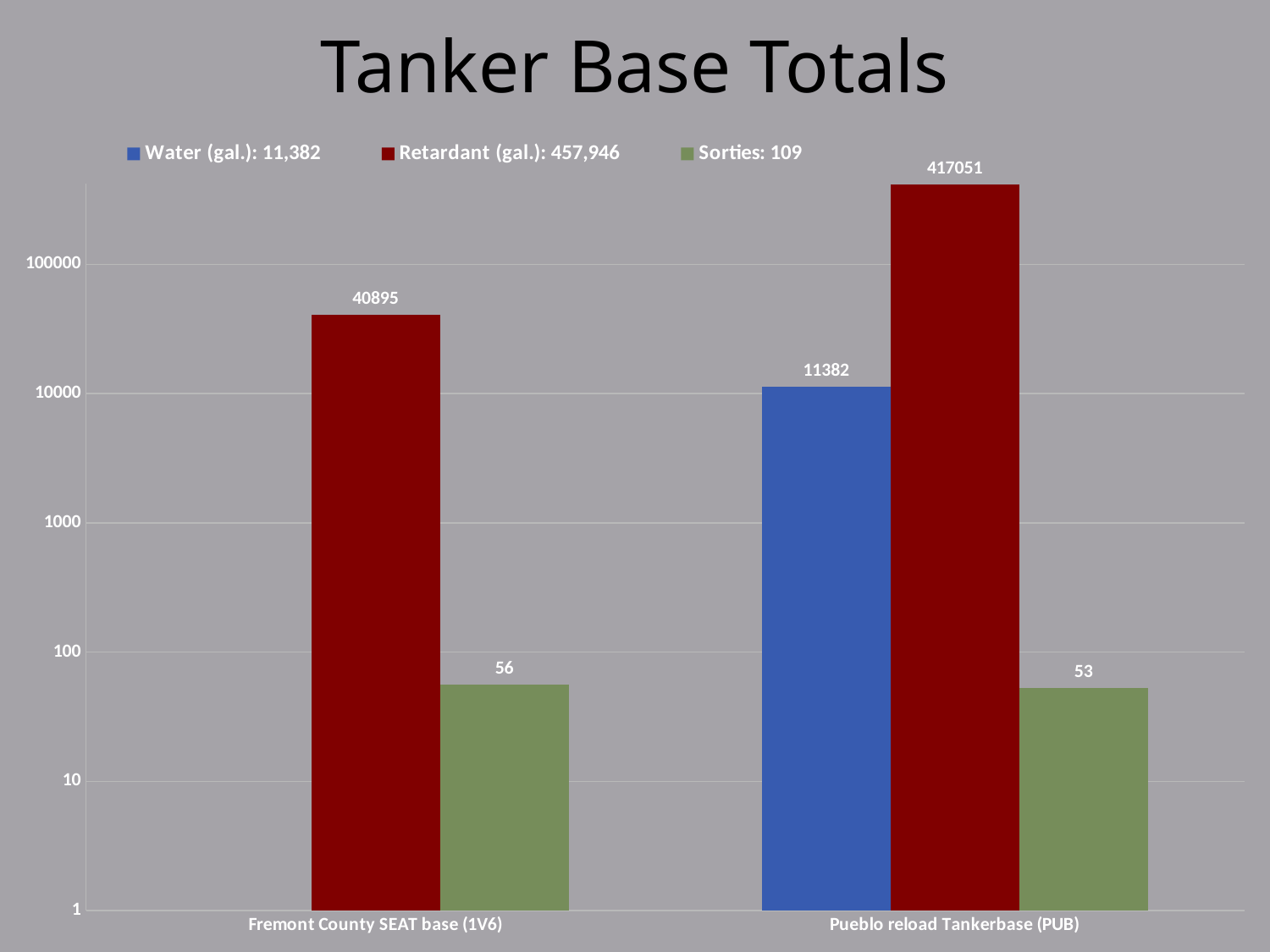
What is the difference in Retardant (gal.) between Pueblo reload Tankerbase (PUB) and Fremont County SEAT base (1V6)? 376156 Is the Retardant (gal.) value for Fremont County SEAT base (1V6) greater or less than 10000? greater How many series does the legend list? 3 Which base has the higher Retardant (gal.) value? Pueblo reload Tankerbase (PUB) Which base has the lower number of Sorties? Pueblo reload Tankerbase (PUB) What is the Retardant (gal.) value for Fremont County SEAT base (1V6)? 40895 What kind of chart is shown on the slide? Bar chart What is the difference in Sorties between Fremont County SEAT base (1V6) and Pueblo reload Tankerbase (PUB)? 3 What is the Water (gal.) value for Pueblo reload Tankerbase (PUB)? 11382 How many Sorties are shown for Fremont County SEAT base (1V6)? 56 What is the Retardant (gal.) value for Pueblo reload Tankerbase (PUB)? 417051 What is the title of the chart? Tanker Base Totals